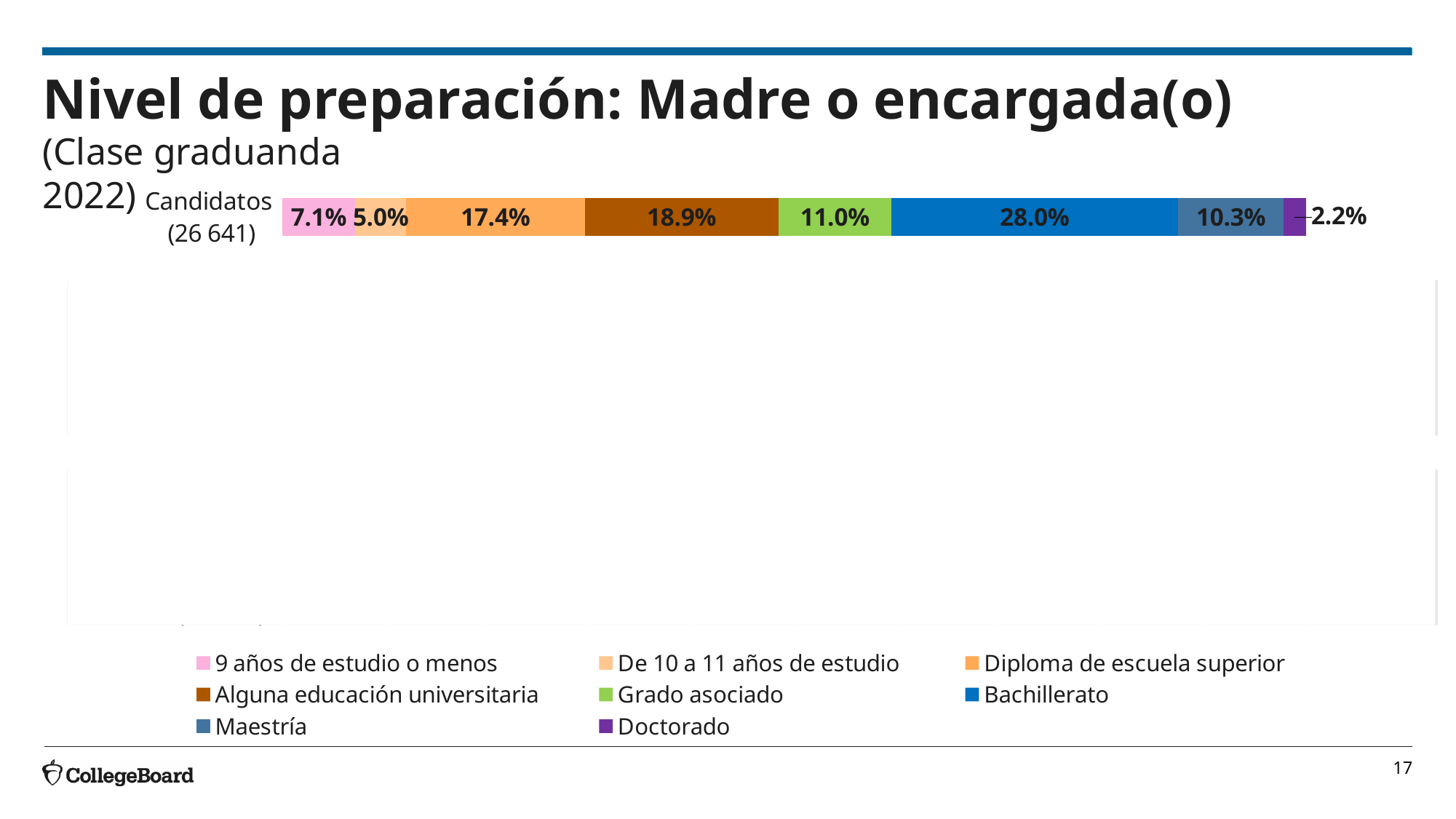
Which is larger, Diploma de escuela superior or Grado asociado? Diploma de escuela superior What is the difference between the Bachillerato and Maestría values? 17.7% How many series does the legend list? 8 What is the value for De 10 a 11 años de estudio? 5.0% What kind of chart is shown on the slide? Stacked bar chart What percentage of candidates have a mother or guardian with a Bachillerato? 28.0% How many candidates are indicated in the category label? 26 641 What is the value for Doctorado? 2.2% What is the total of all segments in the bar? 99.9% Which education level has the lowest share? Doctorado Which education level has the highest share? Bachillerato What is the value for Alguna educación universitaria? 18.9%